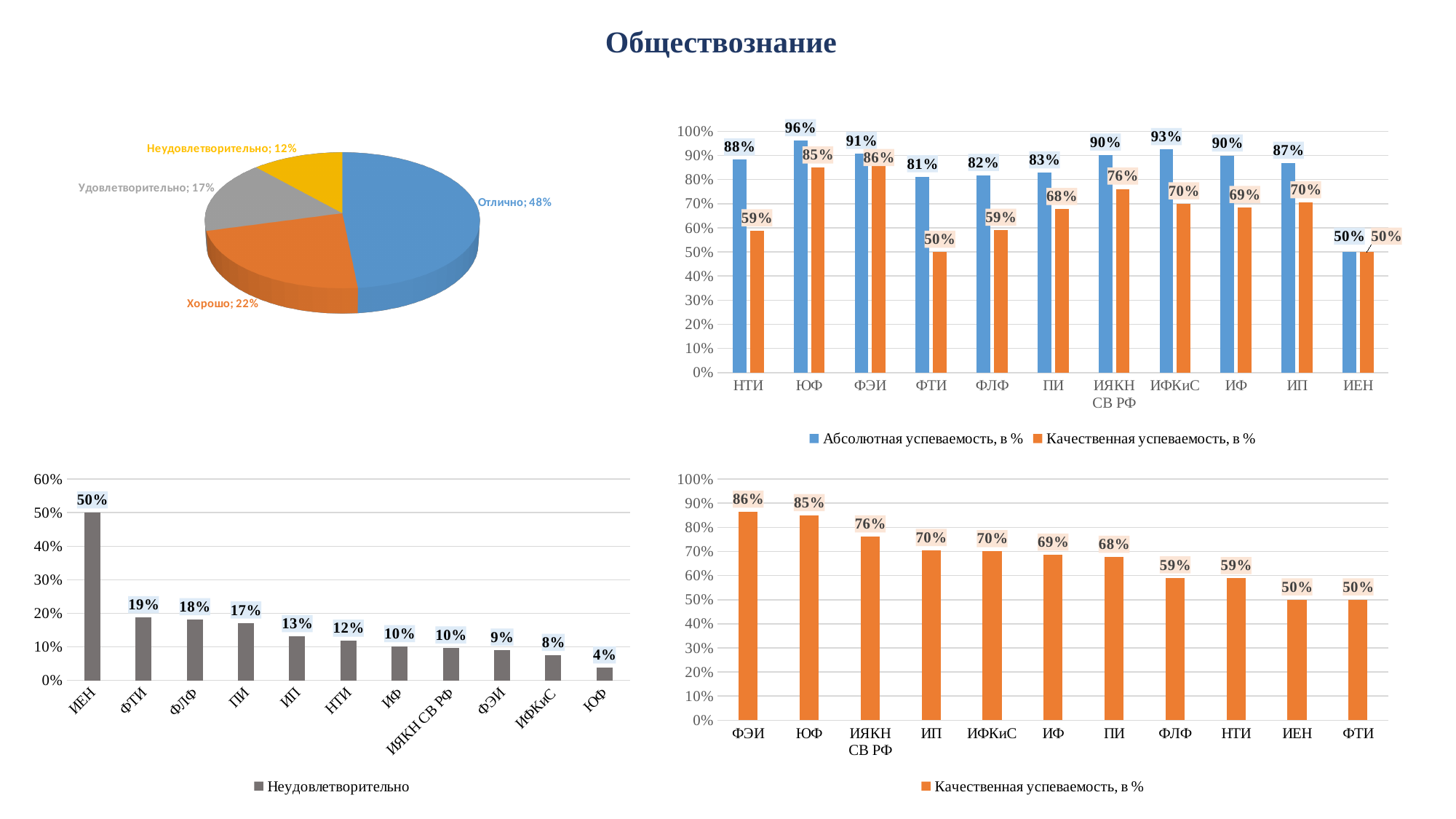
In the pie chart at the top left, how many slices are there? 4 In the bar chart at the bottom left, which category has the highest value? ИЕН In the grouped bar chart at the top right, what is the difference between the two values for НТИ? 29% In the pie chart at the top left, which category has the smallest slice? Неудовлетворительно In the pie chart at the top left, what share is labelled "Отлично"? 48% In the grouped bar chart at the top right, what is the value of "Качественная успеваемость, в %" for ФТИ? 50% In the bar chart at the bottom right, which category has the highest value? ФЭИ In the bar chart at the bottom left, do the values rise or fall from left to right? fall In the grouped bar chart at the top right, how many series does the legend list? 2 In the bar chart at the bottom left, what is the value for ЮФ? 4% In the bar chart at the bottom right, which is larger, the value for ИЯКН СВ РФ or the value for ФЛФ? ИЯКН СВ РФ In the grouped bar chart at the top right, what is the value of "Абсолютная успеваемость, в %" for ЮФ? 96%